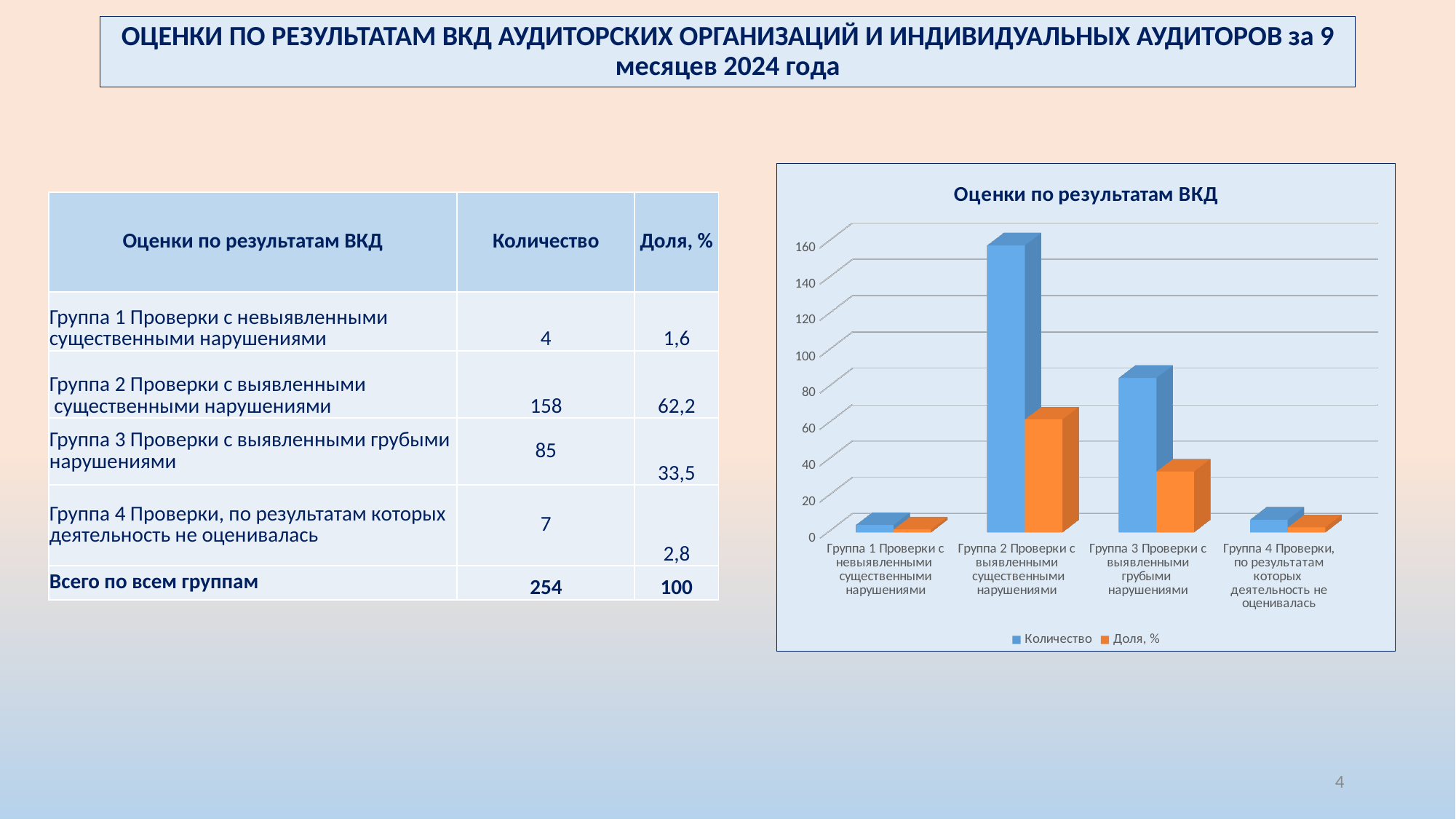
What kind of chart is shown on the slide? bar chart Is the Количество value for Группа 2 greater or less than 140? greater Which is larger in the chart: the Количество value for Группа 3 or the Количество value for Группа 4? Группа 3 What is the Доля, % value for Группа 3 Проверки с выявленными грубыми нарушениями, as printed on the slide? 33,5 Which group has the highest Количество value in the chart? Группа 2 Проверки с выявленными существенными нарушениями What is the Количество value for Группа 2 Проверки с выявленными существенными нарушениями, as printed on the slide? 158 How many groups (categories) are plotted on the x axis of the chart? 4 Is the Доля, % value for Группа 2 greater or less than 80? less What is the title of the chart? Оценки по результатам ВКД Which group has the lowest Количество value in the chart? Группа 1 Проверки с невыявленными существенными нарушениями Is the Количество value for Группа 3 greater or less than 100? less How many series does the chart legend list? 2